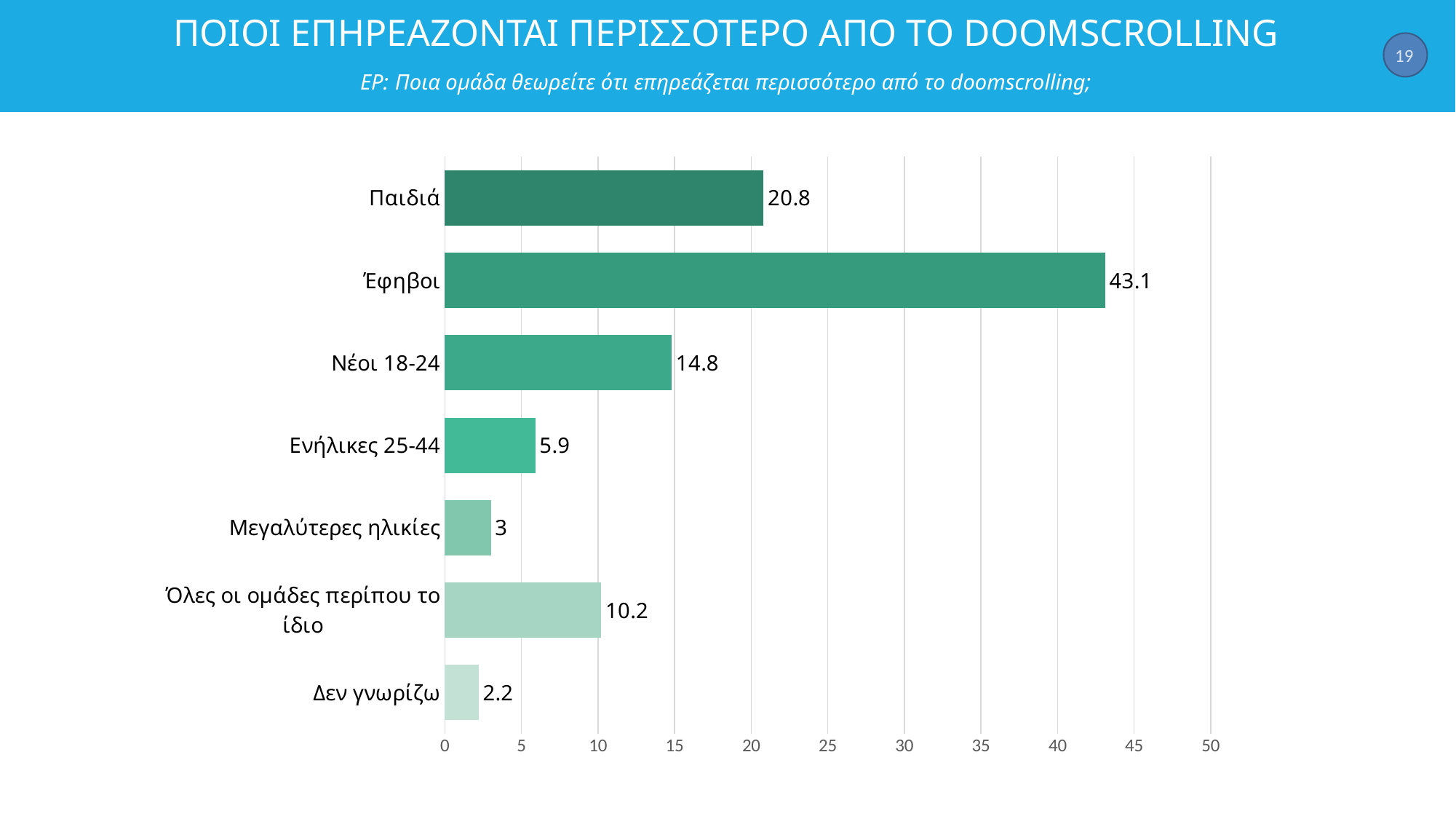
Which category has the highest value? Έφηβοι Which category has the lowest value? Δεν γνωρίζω What is the value for Όλες οι ομάδες περίπου το ίδιο? 10.2 Is the value for Έφηβοι greater or less than 40? greater What is the value for Νέοι 18-24? 14.8 Which is larger, the value for Ενήλικες 25-44 or the value for Μεγαλύτερες ηλικίες? Ενήλικες 25-44 What is the difference between the values for Έφηβοι and Παιδιά? 22.3 How many categories are shown in the chart? 7 What is the value for Δεν γνωρίζω? 2.2 What kind of chart is shown on the slide? bar chart What is the value for Έφηβοι? 43.1 What is the value for Παιδιά? 20.8